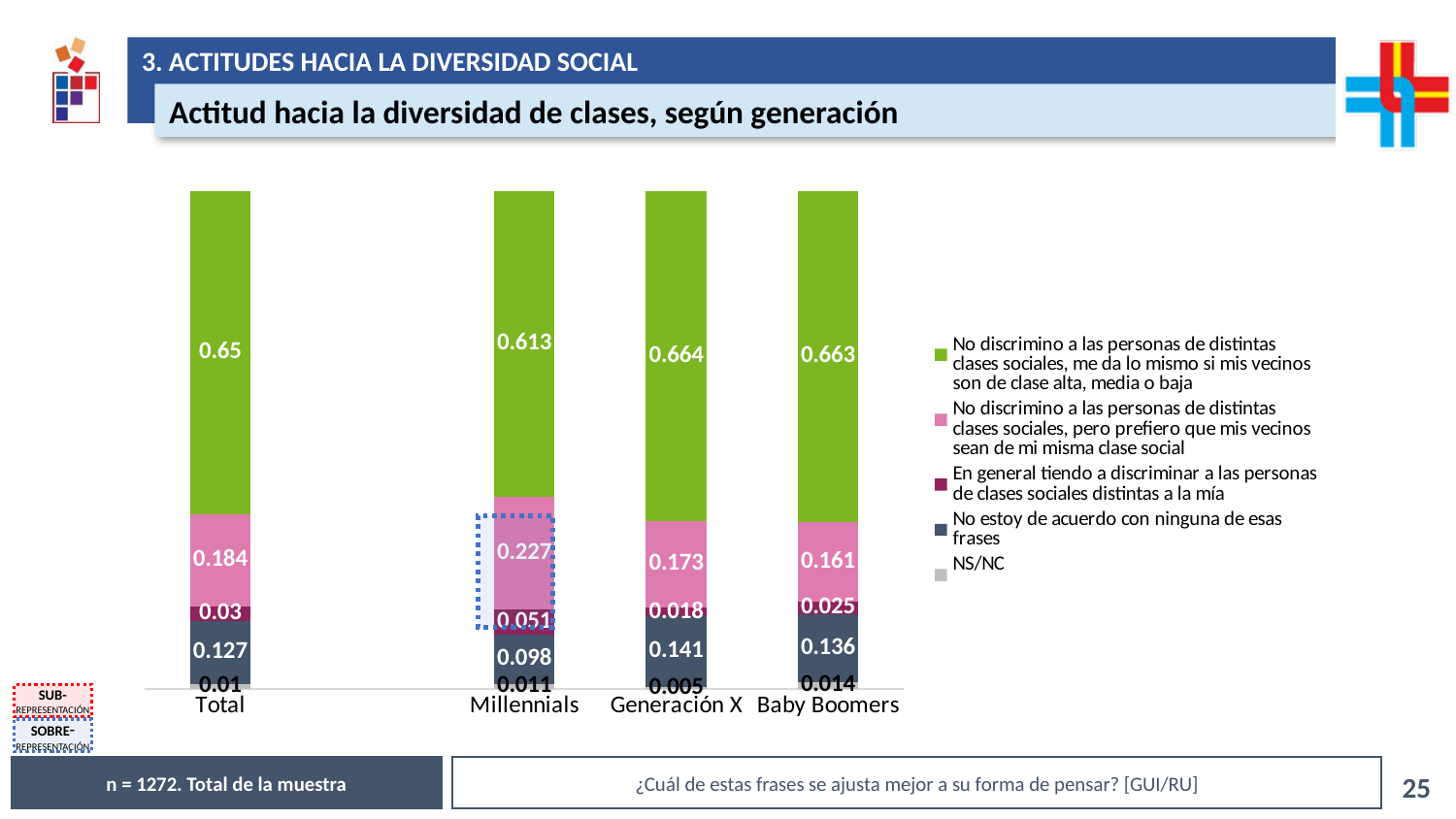
What is the NS/NC value for Baby Boomers? 0.014 What is the value of the 'En general tiendo a discriminar a las personas de clases sociales distintas a la mía' segment for Millennials? 0.051 What is the value of the 'No discrimino ... pero prefiero que mis vecinos sean de mi misma clase social' segment for Millennials? 0.227 How many series does the legend list? 5 Which generation has the highest value for 'No discrimino ... pero prefiero que mis vecinos sean de mi misma clase social'? Millennials What is the value of the 'No discrimino a las personas de distintas clases sociales, me da lo mismo si mis vecinos son de clase alta, media o baja' segment for Total? 0.65 What is the difference between the 'prefiero que mis vecinos sean de mi misma clase social' values for Millennials and Total? 0.043 How many categories are shown on the x axis? 4 What kind of chart is shown on the slide? Stacked bar chart What is the value of the 'No estoy de acuerdo con ninguna de esas frases' segment for Generación X? 0.141 Which category has the lowest NS/NC value? Generación X Which is larger, the 'No estoy de acuerdo con ninguna de esas frases' value for Millennials or for Generación X? Generación X